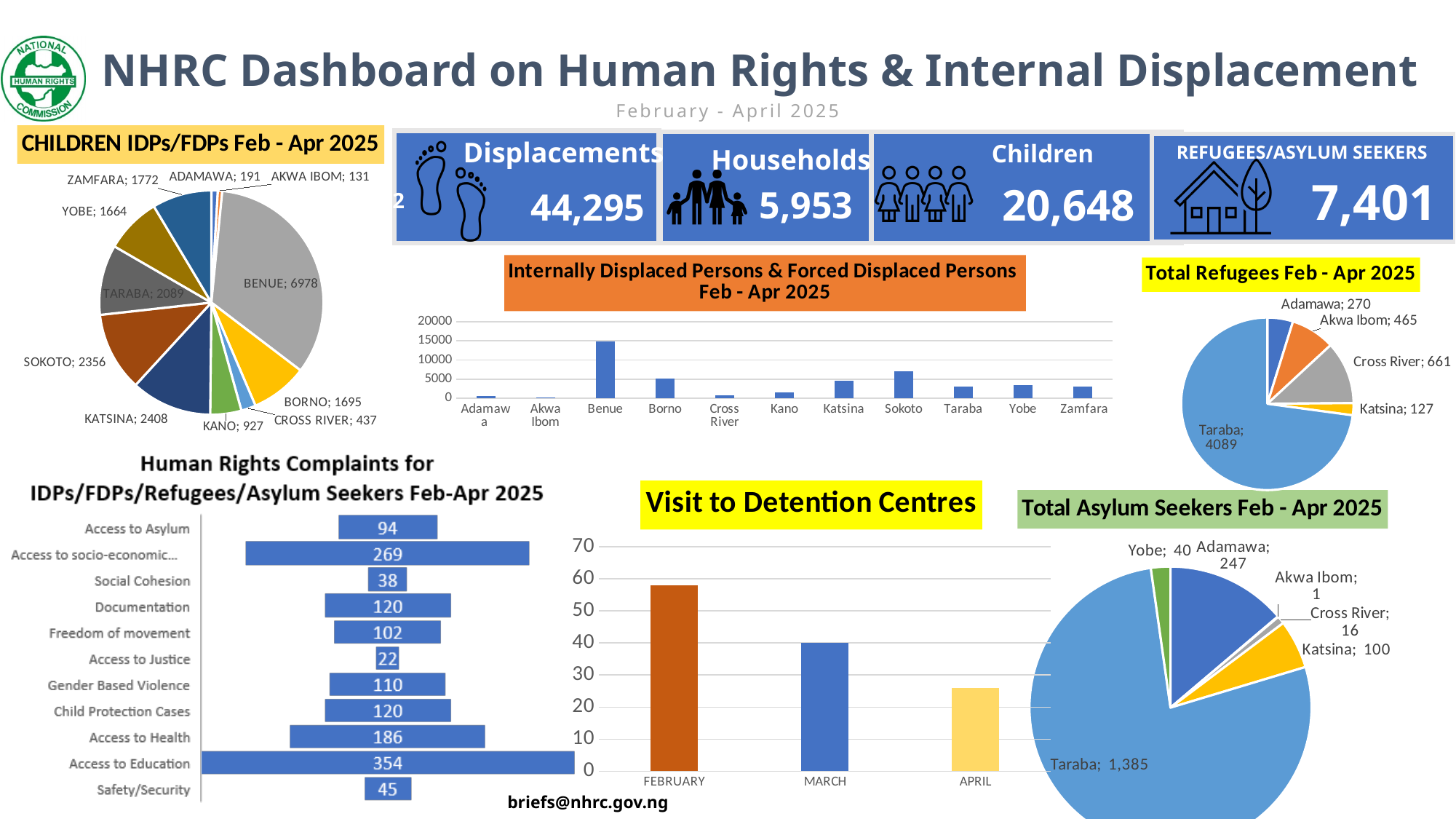
In the Total Refugees Feb - Apr 2025 pie chart, what is the value for Cross River? 661 In the CHILDREN IDPs/FDPs Feb - Apr 2025 pie chart, which state has the smallest value? AKWA IBOM In the Human Rights Complaints chart, which category has the highest value? Access to Education In the Internally Displaced Persons & Forced Displaced Persons Feb - Apr 2025 chart, which state has the highest bar? Benue In the Internally Displaced Persons & Forced Displaced Persons Feb - Apr 2025 chart, is the value for Benue greater or less than 10000? greater What kind of chart is the Internally Displaced Persons & Forced Displaced Persons Feb - Apr 2025 chart? bar chart In the CHILDREN IDPs/FDPs Feb - Apr 2025 pie chart, how many states are shown? 11 In the Visit to Detention Centres chart, do the values rise or fall from February to April? fall In the Human Rights Complaints chart, what is the value for Access to Justice? 22 In the Total Asylum Seekers Feb - Apr 2025 pie chart, what is the value for Taraba? 1,385 In the Total Refugees Feb - Apr 2025 pie chart, what is the difference between Akwa Ibom and Adamawa? 195 In the CHILDREN IDPs/FDPs Feb - Apr 2025 pie chart, what is the value for BENUE? 6978